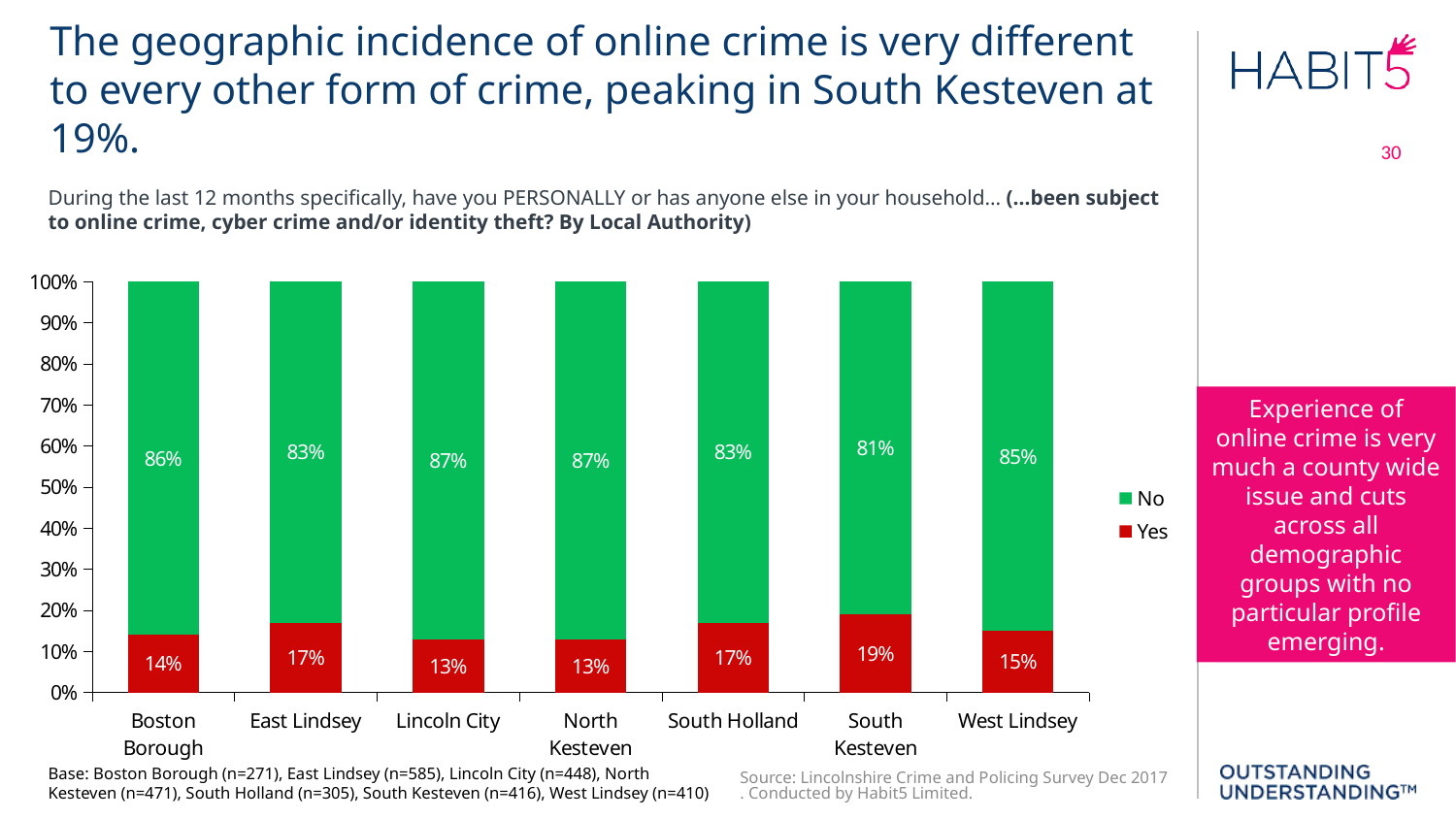
What is the total of the Yes and No values for North Kesteven? 100% What is the Yes value for West Lindsey? 15% What kind of chart is shown on the slide? Stacked bar chart How many local authorities are shown on the x axis? 7 What percentage of respondents in Lincoln City answered No? 87% Which local authority has the lowest No percentage? South Kesteven Which has a higher Yes percentage, East Lindsey or West Lindsey? East Lindsey Which local authority has the highest Yes percentage? South Kesteven What is the difference between the Yes percentages for South Kesteven and Boston Borough? 5% How many series does the legend list? 2 Which colour represents the Yes series in the legend? Red What percentage of respondents in South Kesteven answered Yes? 19%